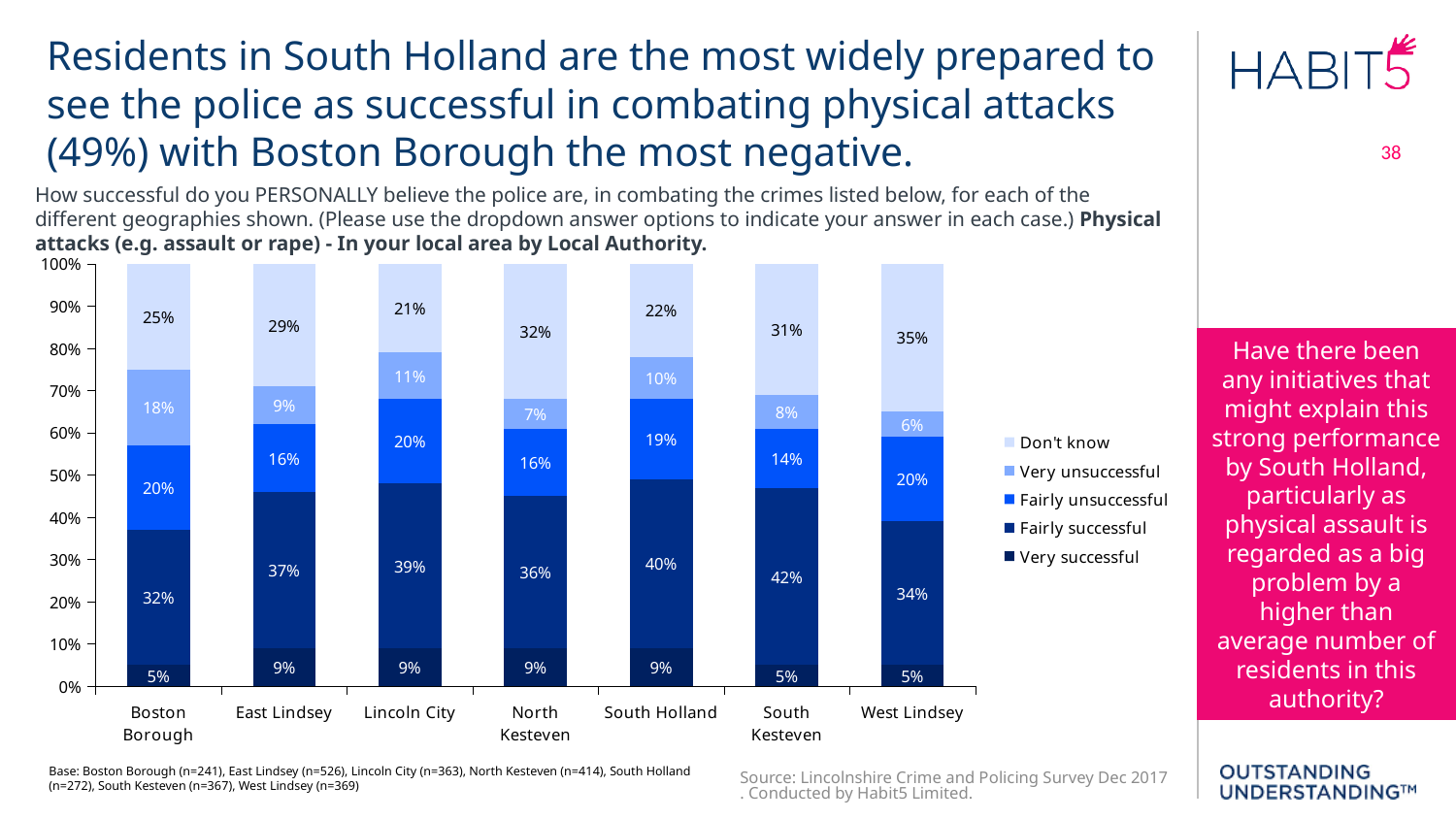
What percentage of Boston Borough residents said the police are 'Fairly successful' in combating physical attacks? 32% How many local authorities are shown on the x axis? 7 What is the 'Very unsuccessful' value for Lincoln City? 11% How many series does the legend list? 5 What kind of chart is shown on the slide? Stacked bar chart What is the combined 'Very successful' and 'Fairly successful' total for South Holland? 49% Which legend entry is shown in the lightest shade of blue? Don't know Which local authority has the highest 'Fairly successful' value? South Kesteven What is the 'Don't know' value for West Lindsey? 35% What is the difference between the 'Don't know' values for West Lindsey and Lincoln City? 14 percentage points Which local authority has the lowest 'Very unsuccessful' value? West Lindsey Which is larger: the 'Fairly unsuccessful' value for Boston Borough or for South Kesteven? Boston Borough